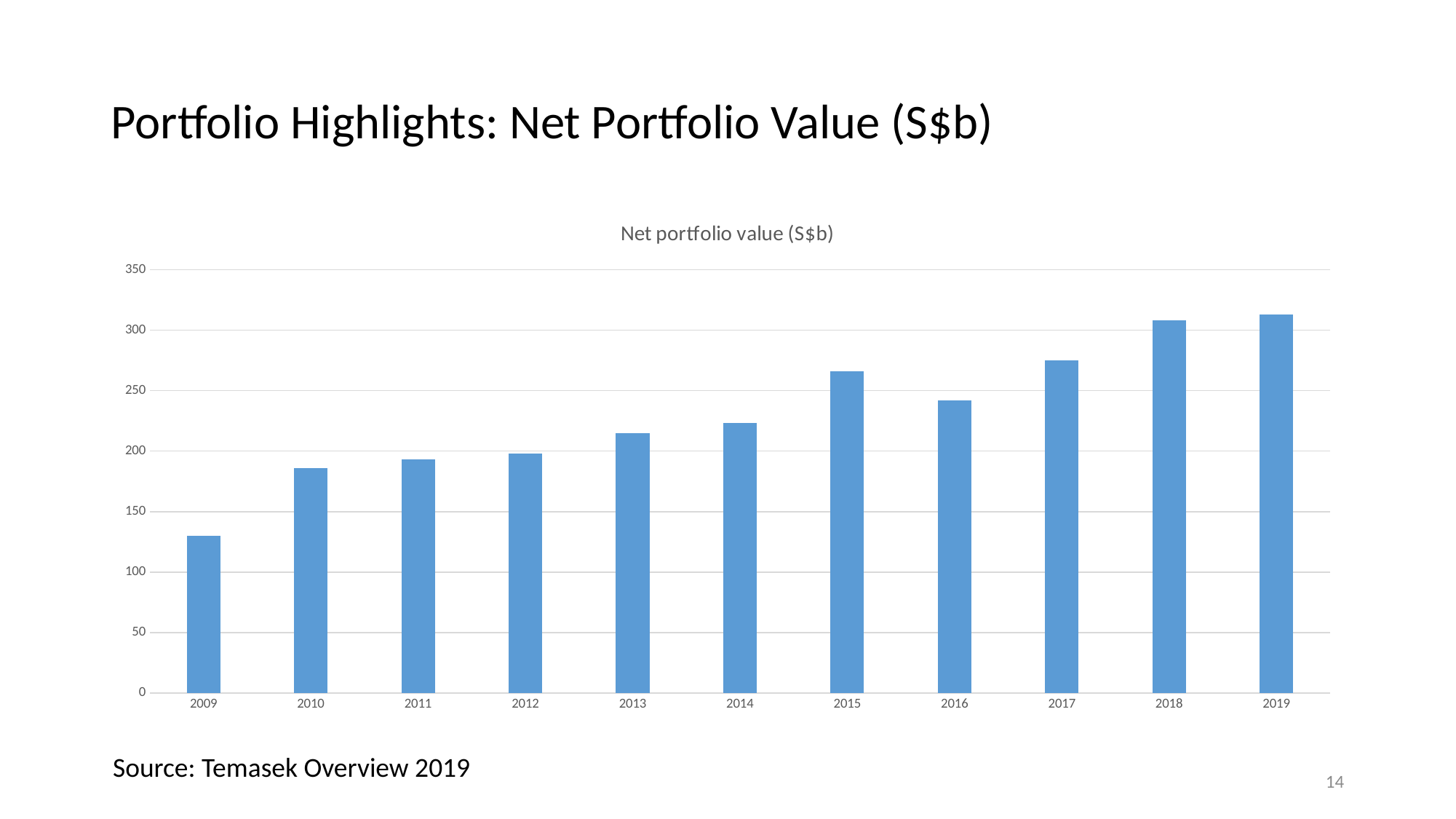
Which year has the larger net portfolio value, 2015 or 2016? 2015 Is the net portfolio value for 2016 greater or less than 250? less Do the net portfolio values generally rise or fall from 2009 to 2019? rise What kind of chart is shown on the slide? bar chart How many years are plotted on the x axis? 11 Is the net portfolio value for 2010 greater or less than 150? greater What is the title of the chart? Net portfolio value (S$b) Is the net portfolio value for 2018 greater or less than 300? greater Which year has the lowest net portfolio value? 2009